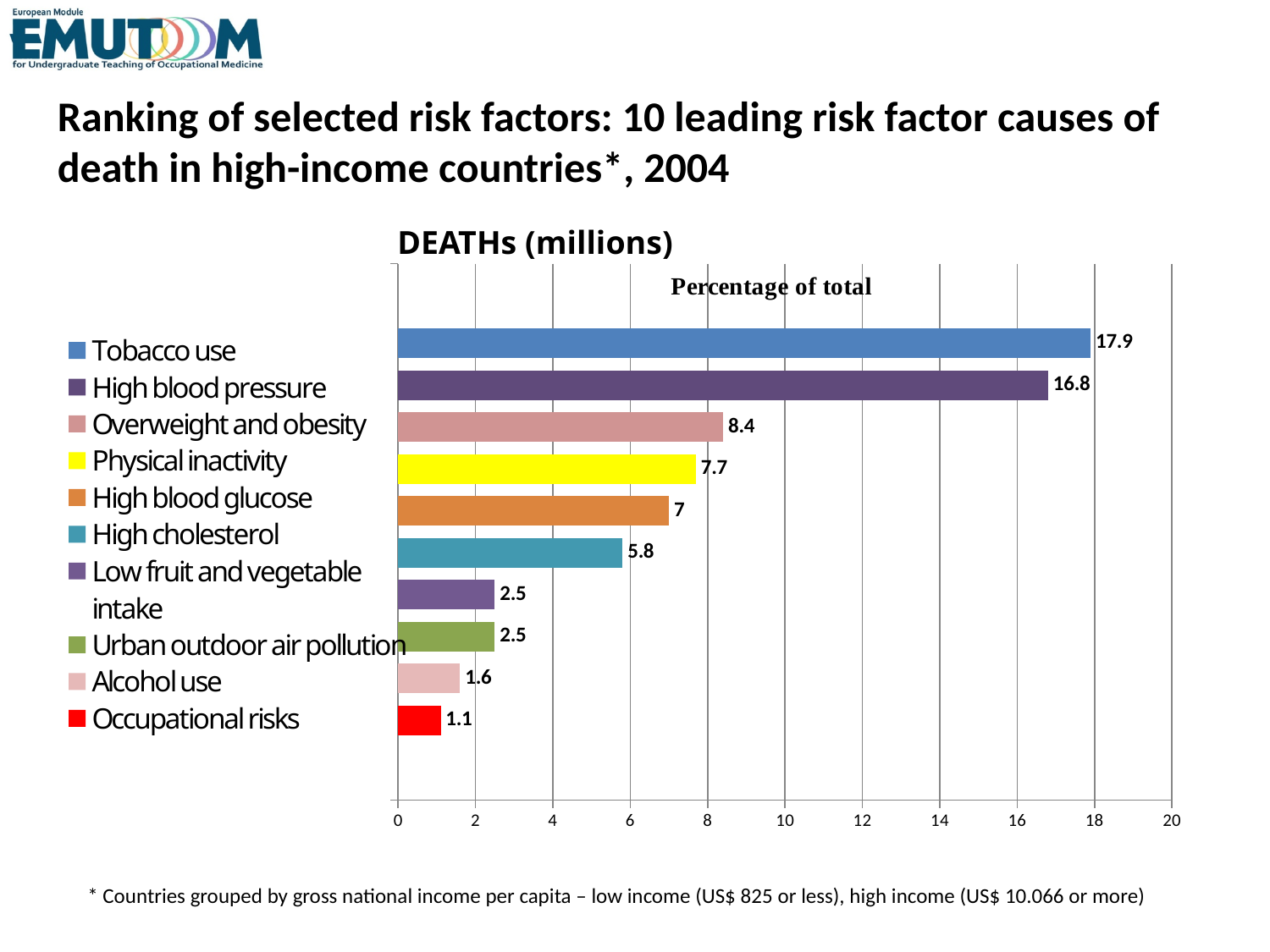
What is the value for Occupational risks? 1.1 What type of chart is shown on the slide? bar chart Which risk factor has the lowest value? Occupational risks How many entries does the legend list? 10 Which risk factor has the highest value? Tobacco use How many risk factors are plotted in the chart? 10 What is the value for High cholesterol? 5.8 What is the difference between the values for Tobacco use and High blood pressure? 1.1 Which is larger, the value for Overweight and obesity or the value for Physical inactivity? Overweight and obesity What is the title of the chart? DEATHs (millions) What is the value for Tobacco use? 17.9 What is the value for High blood pressure? 16.8